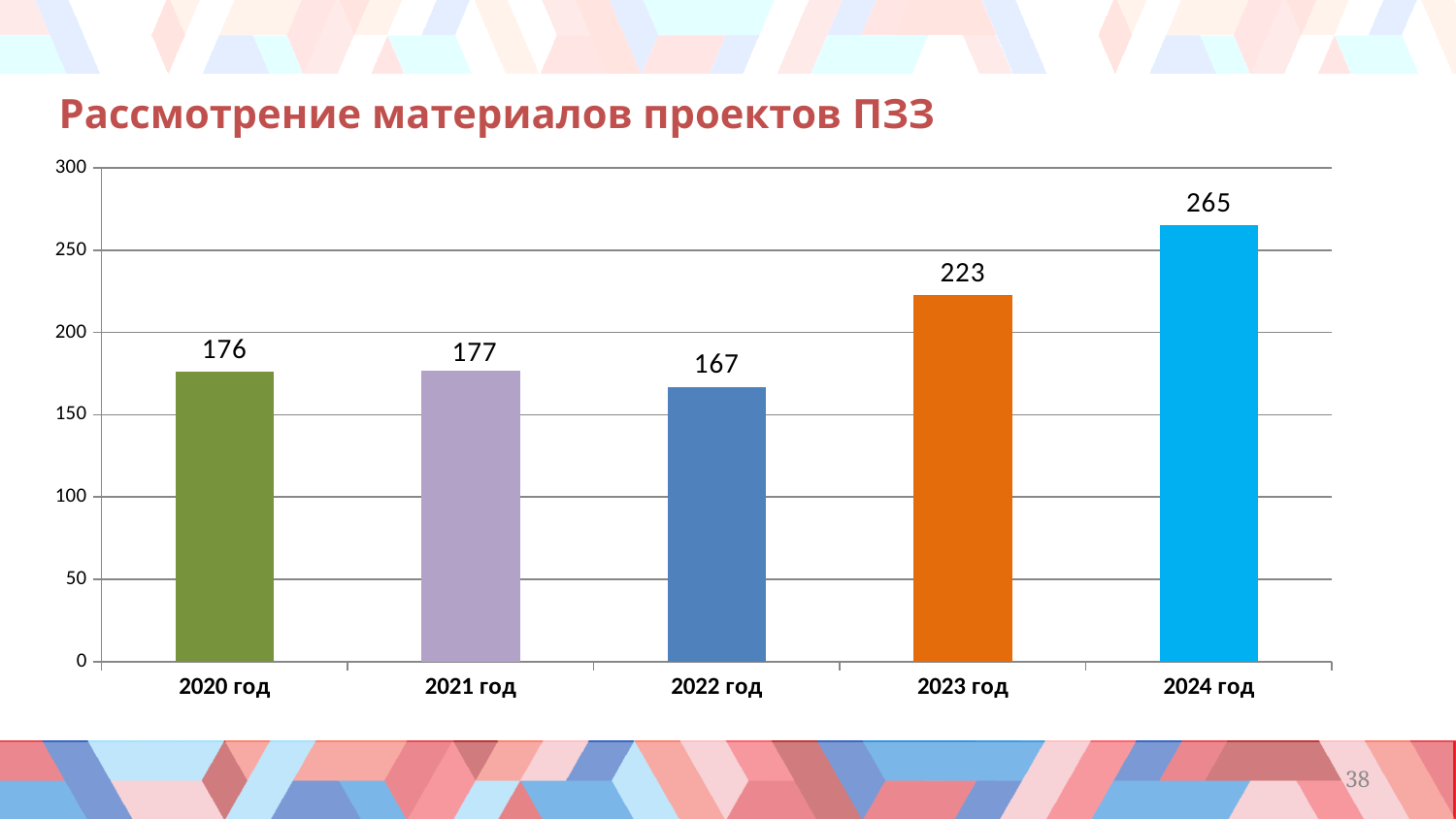
What is the difference between the values for 2024 год and 2023 год? 42 What is the value for 2020 год? 176 What is the title of the slide? Рассмотрение материалов проектов ПЗЗ Which is larger, the value for 2023 год or the value for 2021 год? 2023 год Which year has the highest value? 2024 год What is the value for 2022 год? 167 Is the value for 2023 год greater or less than 200? greater What is the difference between the values for 2020 год and 2022 год? 9 How many years are shown on the x axis? 5 Which year has the lowest value? 2022 год What is the value for 2024 год? 265 What kind of chart is shown on the slide? bar chart